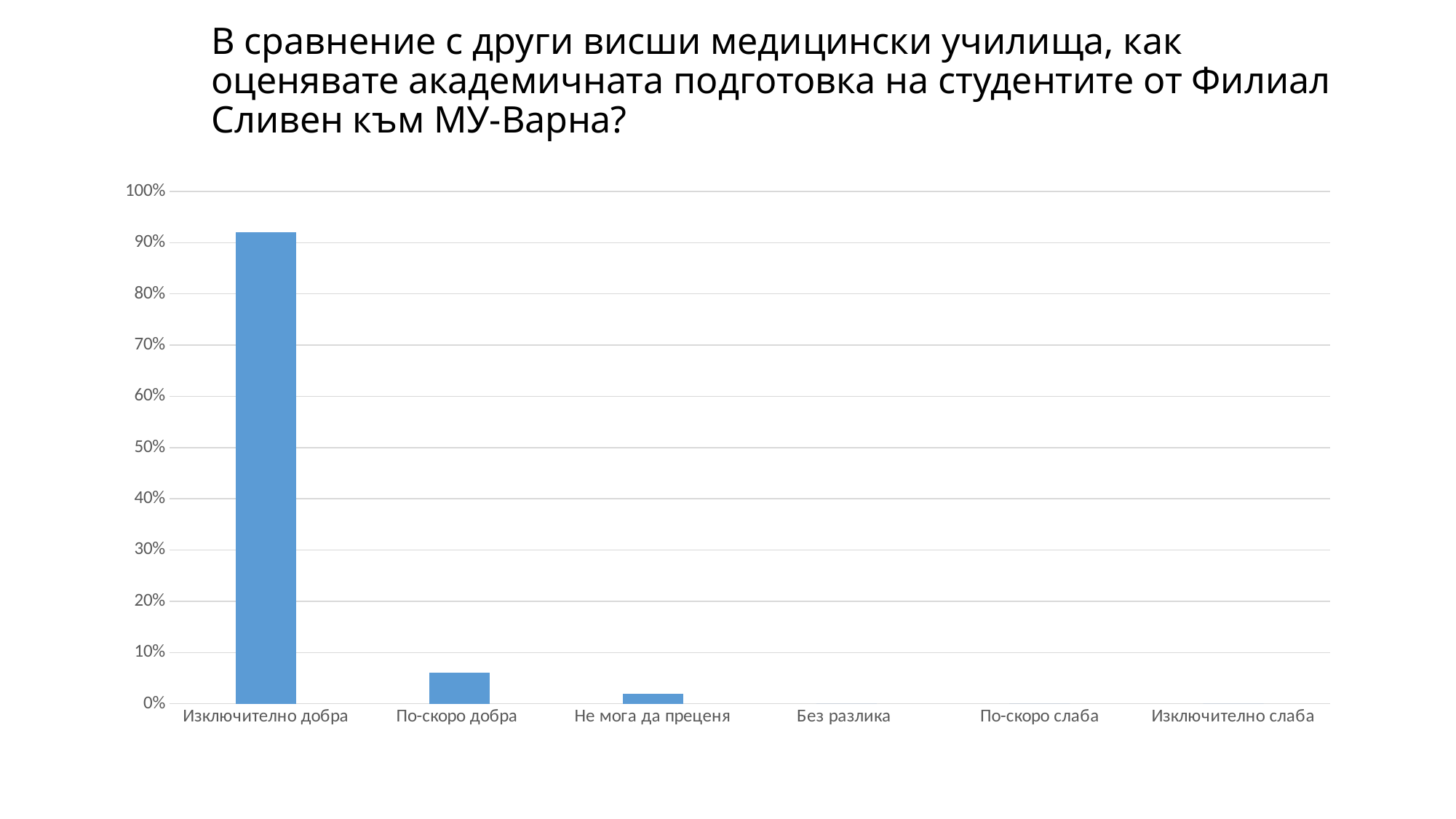
Is the value for По-скоро добра greater or less than 10%? less What is the highest tick value shown on the y axis of the chart? 100% Which is larger, the value for Изключително добра or the value for По-скоро добра? Изключително добра What is the label of the last category on the x axis? Изключително слаба Which category has the highest value in the chart? Изключително добра Is the value for Не мога да преценя greater or less than 10%? less What kind of chart is shown on the slide? bar chart Which is larger, the value for По-скоро добра or the value for Не мога да преценя? По-скоро добра Is the value for Изключително добра greater or less than 80%? greater Do the values rise or fall moving from left to right along the x axis? fall How many categories are shown on the x axis of the chart? 6